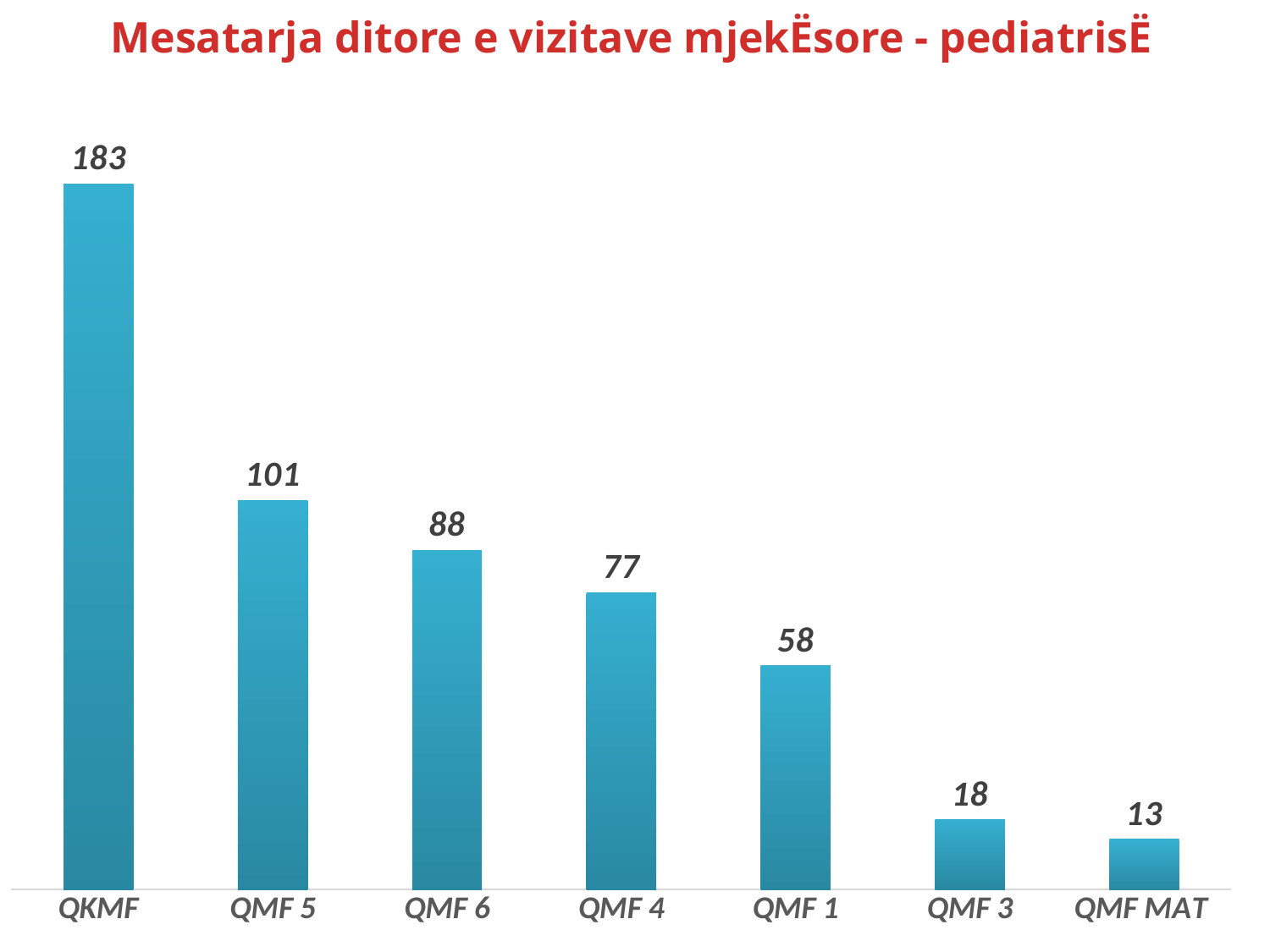
Which category has the highest value? QKMF Which category has the lowest value? QMF MAT What is the difference between the values for QKMF and QMF 5? 82 What is the value for QMF MAT? 13 What is the value for QKMF? 183 Which is larger, the value for QMF 6 or the value for QMF 4? QMF 6 Do the values rise or fall from left to right along the x axis? Fall What is the value for QMF 6? 88 What kind of chart is shown on the slide? Bar chart What is the title of the chart? Mesatarja ditore e vizitave mjekËsore - pediatrisË How many categories are shown on the chart? 7 What is the difference between the values for QMF 4 and QMF 1? 19